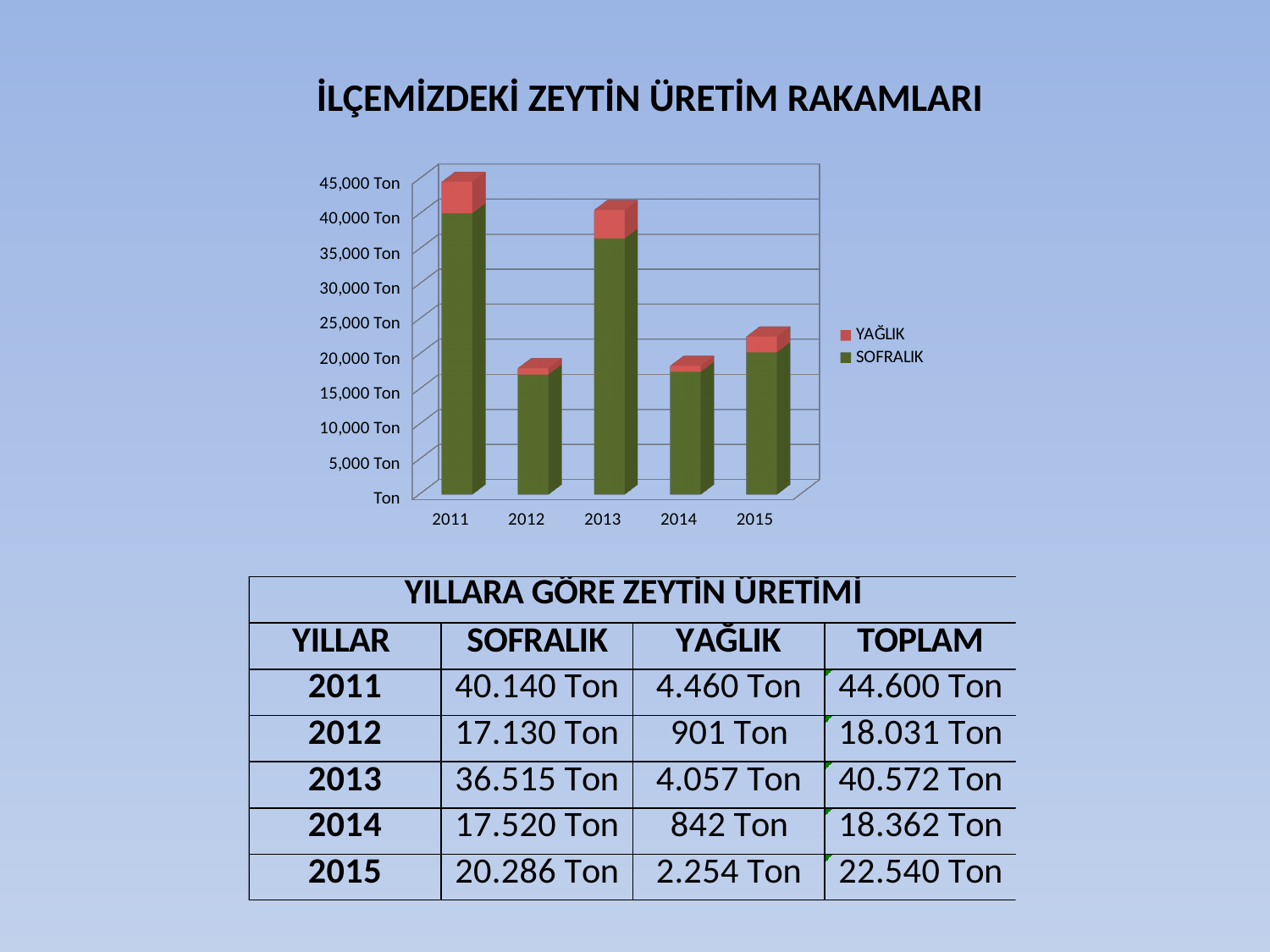
Which year has the lowest total olive production in the chart? 2012 What is the YAĞLIK value for 2015? 2.254 Ton How many years are plotted on the x axis of the chart? 5 Is the SOFRALIK value for 2012 greater or less than 20,000 Ton? less How many series does the chart legend list? 2 Which is larger, the total for 2015 or the total for 2014? 2015 Which year has the highest total olive production in the chart? 2011 What is the SOFRALIK value for 2013? 36.515 Ton Is the total for 2013 greater or less than 40,000 Ton? greater What kind of chart is shown on the slide? Stacked bar chart What is the total of the stacked bar for 2014? 18.362 Ton Which series is shown in red in the chart legend? YAĞLIK